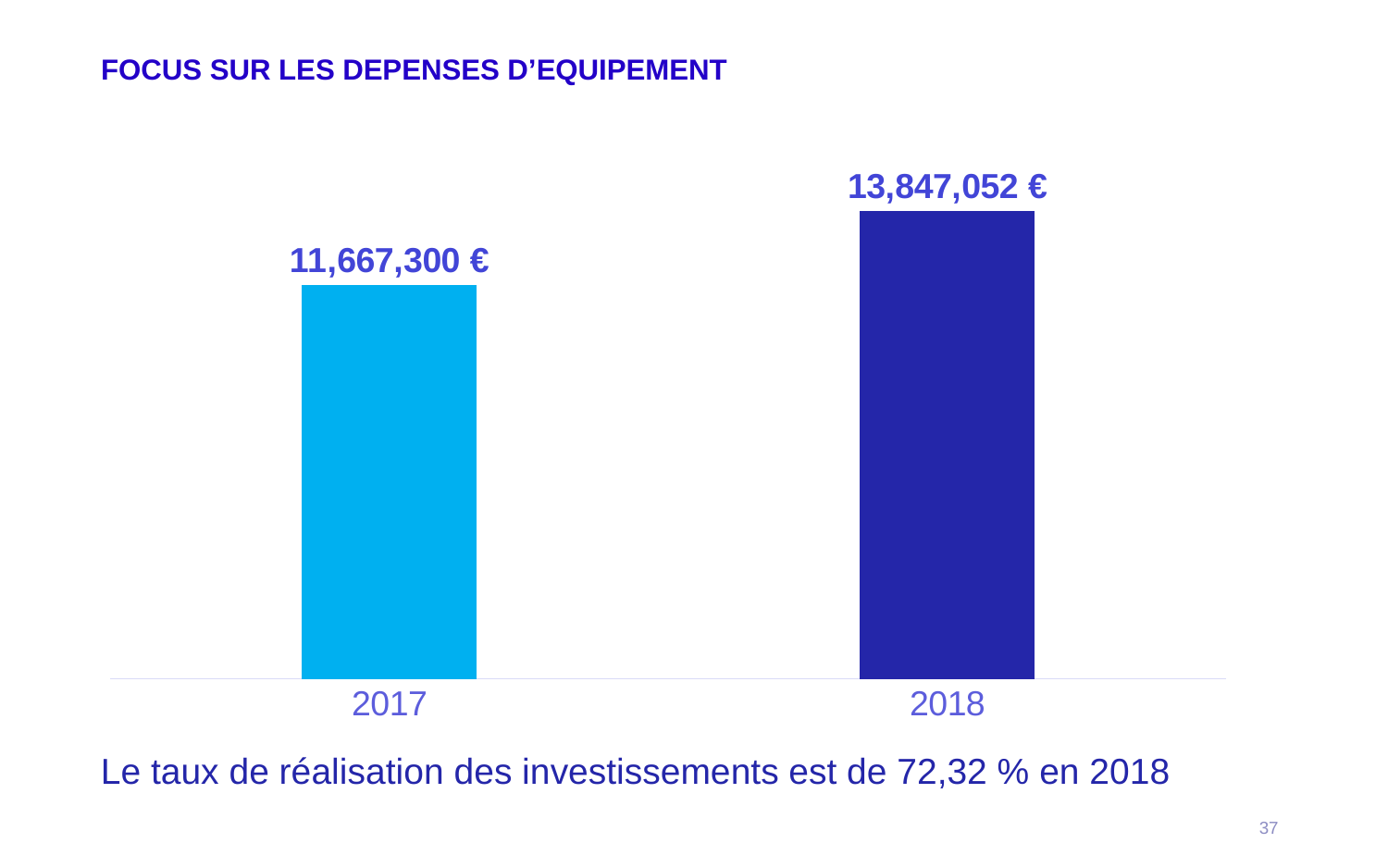
What is the value shown for 2018? 13,847,052 € What kind of chart is shown on the slide? bar chart How many bars are plotted in the chart? 2 Do the values rise or fall from 2017 to 2018? rise Which year has the higher value? 2018 What is the difference between the 2018 value and the 2017 value? 2,179,752 € What is the value shown for 2017? 11,667,300 € What is the heading above the chart on the slide? FOCUS SUR LES DEPENSES D'EQUIPEMENT Is the value for 2018 larger or smaller than the value for 2017? larger What colour is the bar for 2018? dark blue Which year has the lower value? 2017